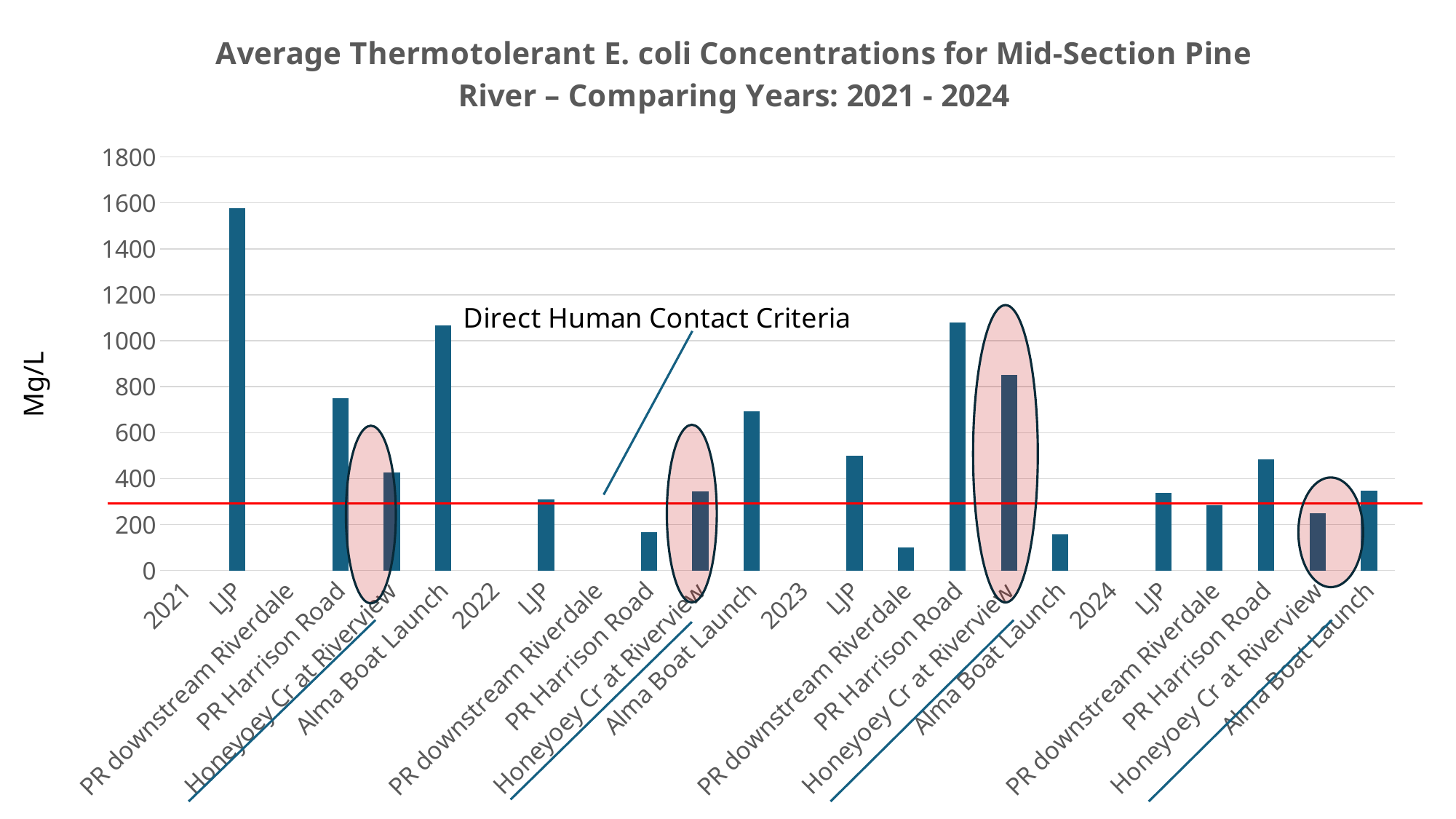
Which is larger: LJP in 2021 or PR Harrison Road in 2023? LJP in 2021 Among the 2024 sites, which has the highest value? PR Harrison Road Is the value for LJP in 2021 greater or less than 1400? greater Is the value for Alma Boat Launch in 2021 greater or less than 1000? greater Among the 2023 sites, which has the lowest value? PR downstream Riverdale Is the value for PR Harrison Road in 2022 greater or less than 200? less Which site and year has the highest average E. coli concentration on the chart? LJP in 2021 In 2023, which is larger: PR Harrison Road or Honeyoey Cr at Riverview? PR Harrison Road What type of chart is shown on the slide? bar chart What does the red horizontal line on the chart represent? Direct Human Contact Criteria